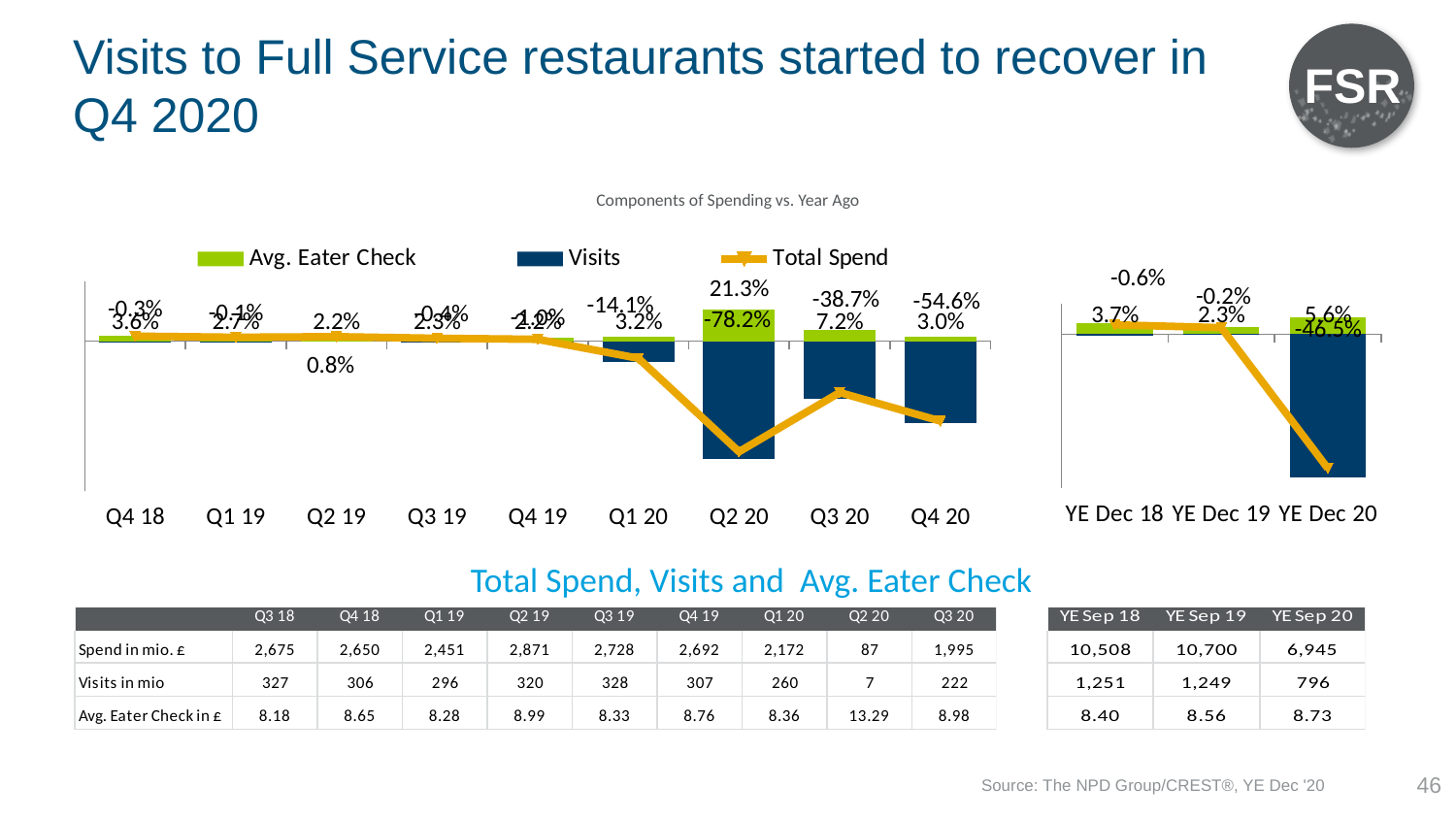
What kind of chart is the 'Components of Spending vs. Year Ago' chart on the left? bar chart with a line In the left chart, which quarter has the higher Visits value, Q3 20 or Q4 20? Q3 20 How many periods are shown on the x axis of the right-hand chart? 3 In the left chart, what is the difference between the Visits values for Q3 20 and Q4 20? 15.9 percentage points How many series does the legend of the left chart list? 3 In the left chart, which quarter has the lowest Visits value? Q2 20 In the left chart, what is the Visits value for Q4 20? -54.6% In the left chart, which quarter has the highest Avg. Eater Check value? Q2 20 How many quarters are shown on the x axis of the left chart? 9 In the left chart, what is the Avg. Eater Check value for Q2 20? 21.3% In the left chart, what is the Visits value for Q3 20? -38.7% In the left chart, what is the Visits value for Q2 20? -78.2%